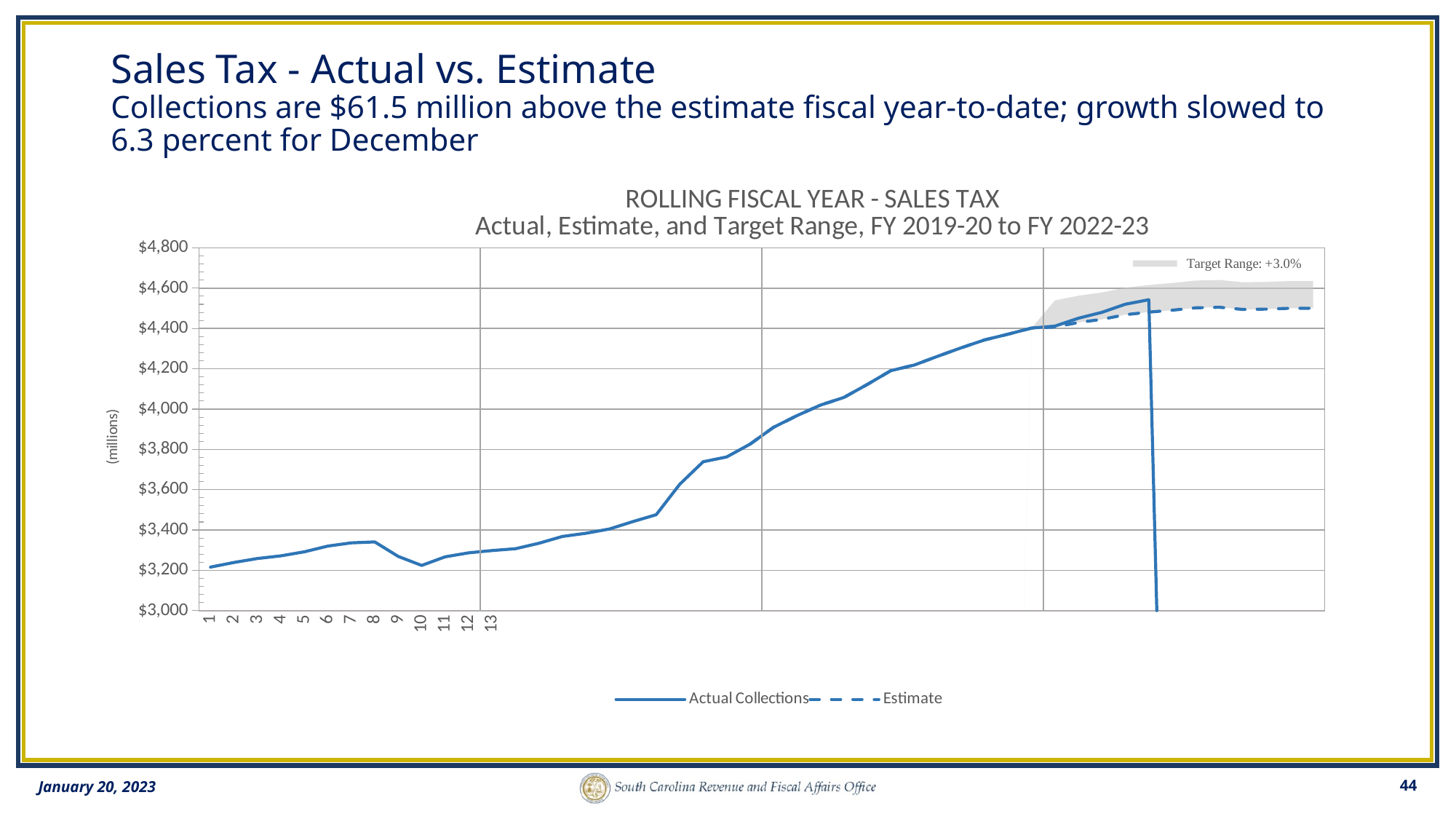
What kind of chart is shown on the slide? Line chart Is the Actual Collections value at point 8 greater or less than $3,400? less How many series does the chart legend list? 2 What is the title of the chart? ROLLING FISCAL YEAR - SALES TAX Actual, Estimate, and Target Range, FY 2019-20 to FY 2022-23 Does the Actual Collections line generally rise or fall from point 1 to its peak near the right of the chart? rise What is the highest value shown on the y-axis? $4,800 Is the Actual Collections value at point 1 greater or less than $3,400? less Is the peak of the Actual Collections line greater or less than $4,400? greater What percentage is given for the Target Range in the chart? +3.0%